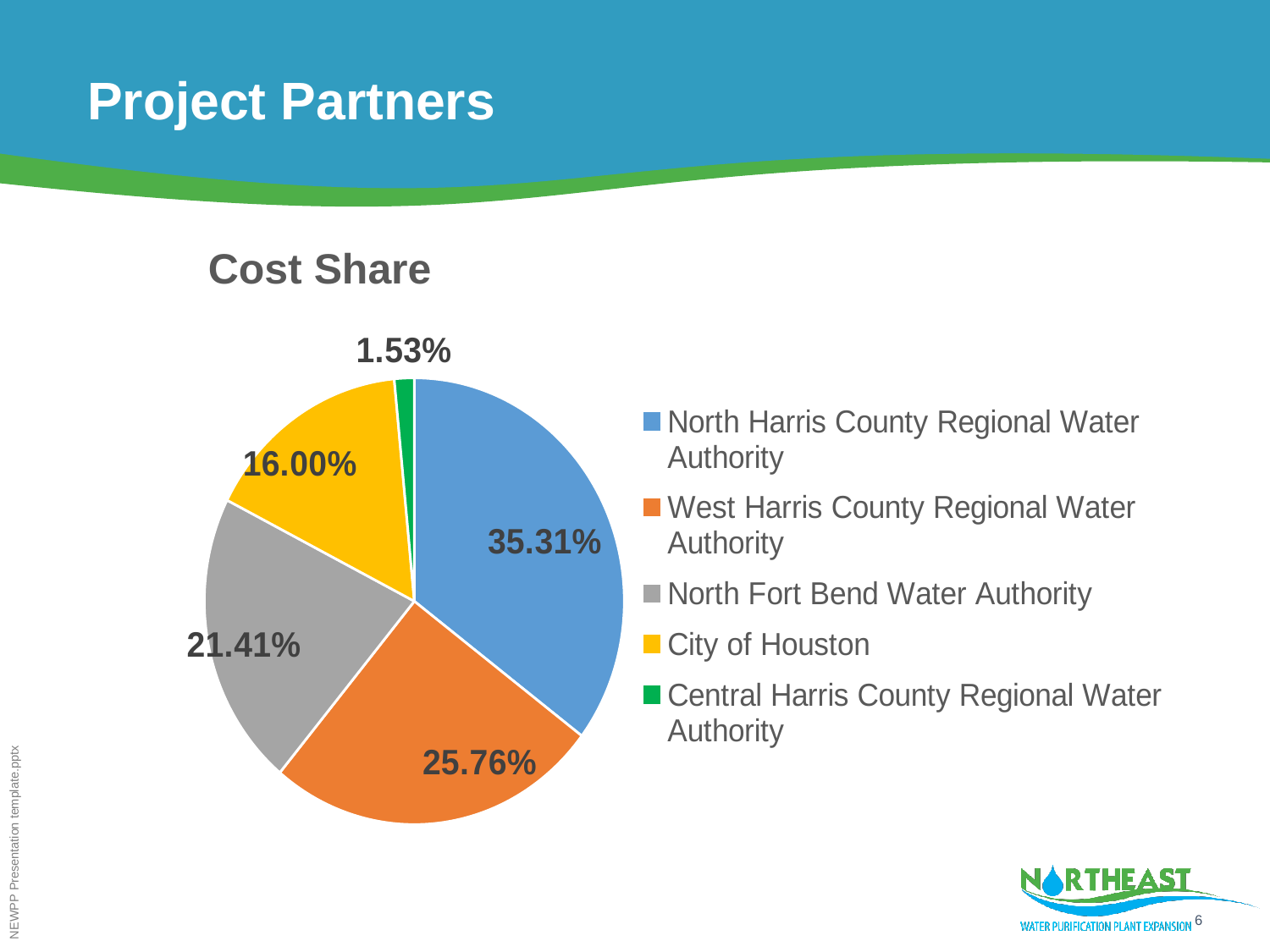
What is the title of the chart? Cost Share What share of the cost does Central Harris County Regional Water Authority have? 1.53% What share of the cost does North Fort Bend Water Authority have? 21.41% What share of the cost does North Harris County Regional Water Authority have? 35.31% Which partner has the largest cost share? North Harris County Regional Water Authority What share of the cost does the City of Houston have? 16.00% What share of the cost does West Harris County Regional Water Authority have? 25.76% Which has a larger cost share, North Fort Bend Water Authority or the City of Houston? North Fort Bend Water Authority What kind of chart is shown on the slide? pie chart How many partners are shown in the pie chart? 5 What is the difference between the cost shares of North Harris County Regional Water Authority and West Harris County Regional Water Authority? 9.55% Which partner has the smallest cost share? Central Harris County Regional Water Authority